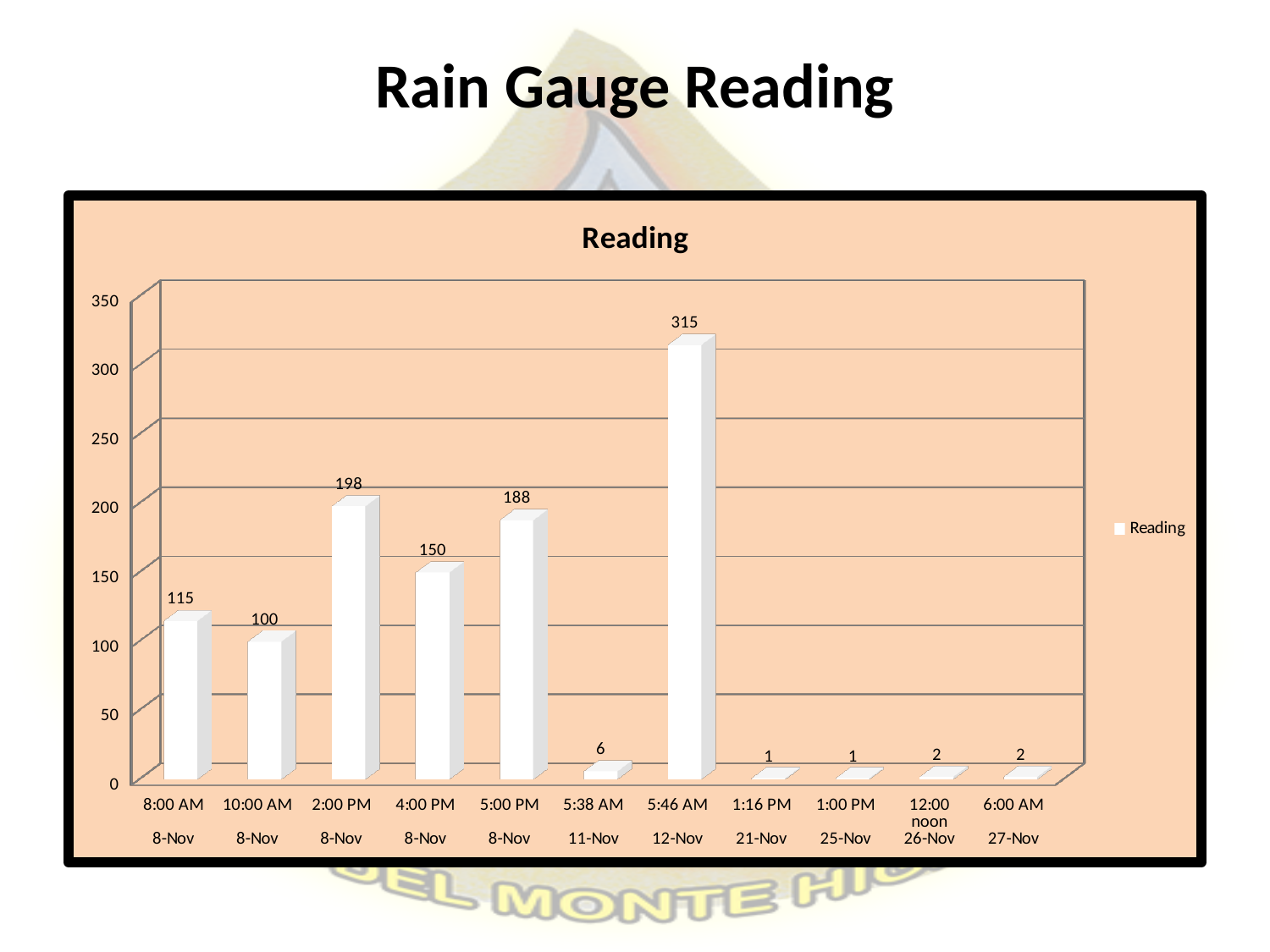
What is the title of the chart inside the plot area? Reading Which time and date has the highest reading? 5:46 AM, 12-Nov What is the lowest reading value shown on the chart? 1 What is the reading at 5:46 AM on 12-Nov? 315 What is the difference between the readings at 2:00 PM on 8-Nov and 5:00 PM on 8-Nov? 10 Which is larger, the reading at 8:00 AM on 8-Nov or at 10:00 AM on 8-Nov? 8:00 AM on 8-Nov What is the reading at 2:00 PM on 8-Nov? 198 How many bars (readings) are plotted on the chart? 11 What is the reading at 5:38 AM on 11-Nov? 6 What kind of chart is shown on the slide? bar chart How many series does the legend list? 1 Is the reading at 4:00 PM on 8-Nov greater or less than 200? less